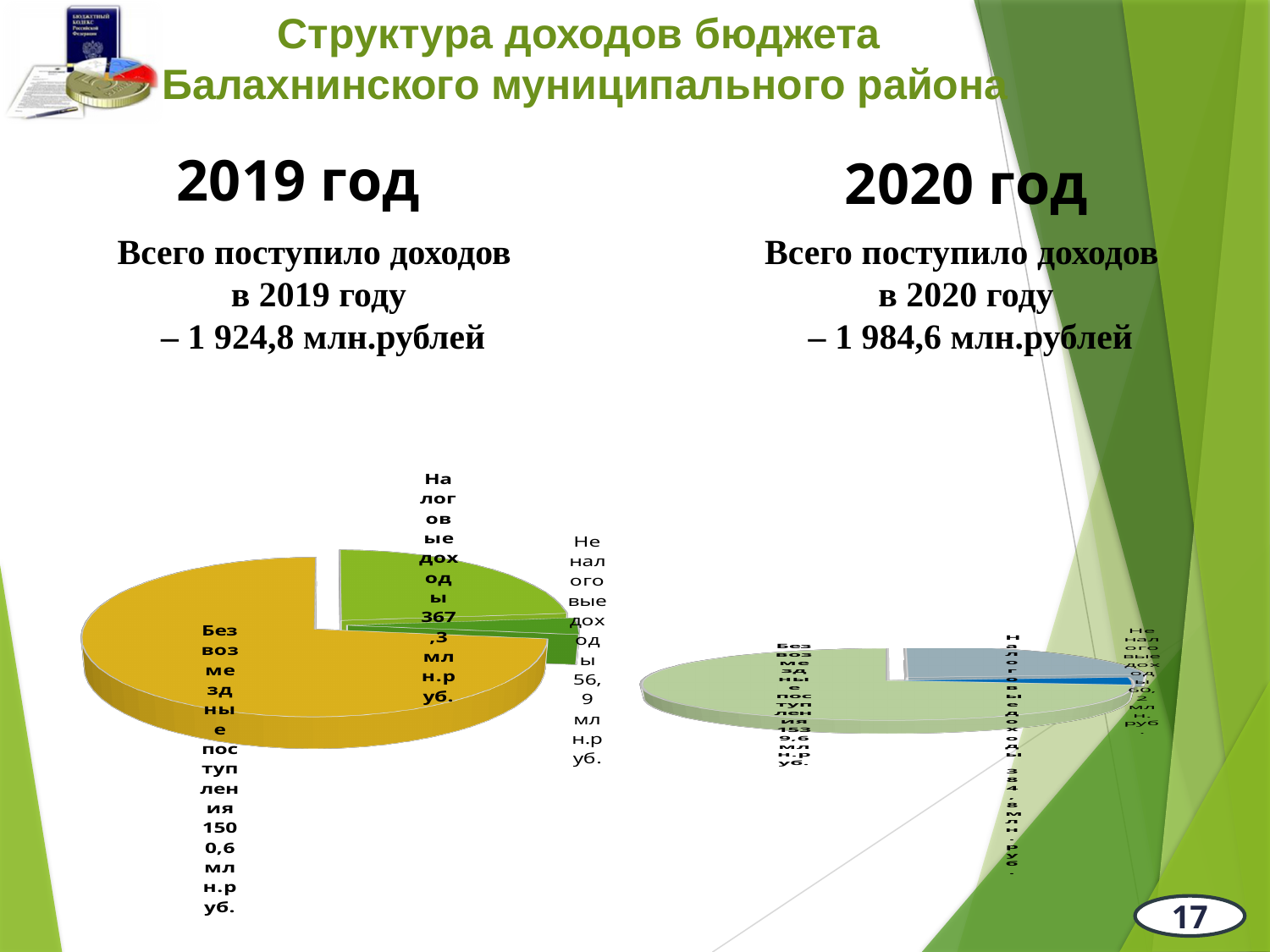
In the 2019 год pie chart, what is the value for Безвозмездные поступления? 1500,6 млн.руб. In the 2019 год pie chart, how many slices are there? 3 In the 2019 год pie chart, what is the value for Налоговые доходы? 367,3 млн.руб. In the 2019 год pie chart, which category has the largest slice? Безвозмездные поступления What kind of chart is used for the 2019 год data on the left? pie chart In the 2019 год pie chart, what is the value for Неналоговые доходы? 56,9 млн.руб. What colour is the Безвозмездные поступления slice in the 2019 год pie chart? yellow In the 2020 год pie chart on the right, what is the value for Налоговые доходы? 384,8 млн.руб. In the 2019 год pie chart, what is the difference between Налоговые доходы and Неналоговые доходы? 310,4 млн.руб. In the 2019 год pie chart, which is larger: Налоговые доходы or Неналоговые доходы? Налоговые доходы In the 2019 год pie chart, which category has the smallest slice? Неналоговые доходы In the 2020 год pie chart on the right, which category has the largest slice? Безвозмездные поступления